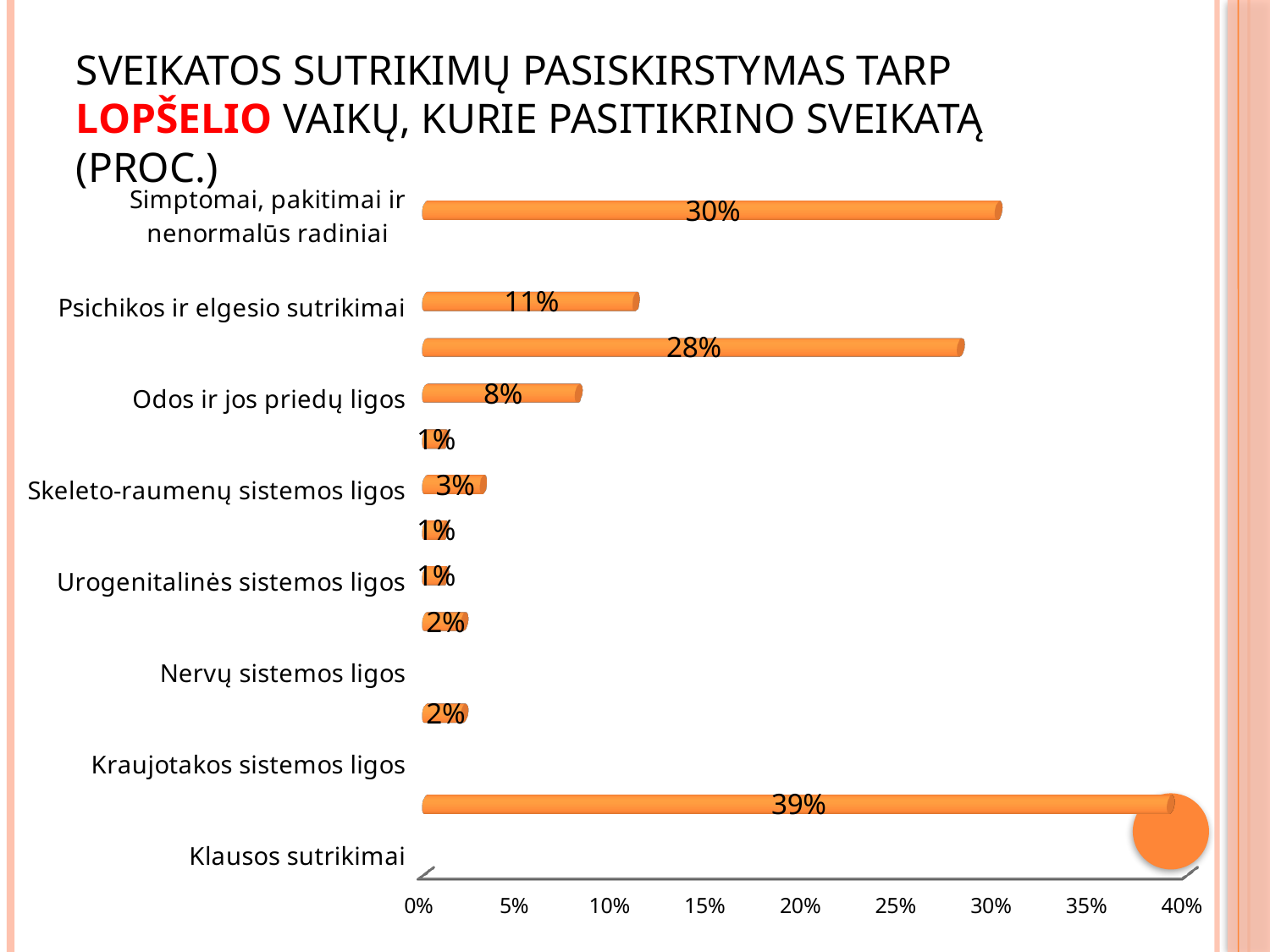
Which is larger, the value for Psichikos ir elgesio sutrikimai or the value for Odos ir jos priedų ligos? Psichikos ir elgesio sutrikimai What is the value for Psichikos ir elgesio sutrikimai? 11% What is the value for Odos ir jos priedų ligos? 8% What is the largest value labelled on any bar in the chart? 39% What is the value for Urogenitalinės sistemos ligos? 1% What kind of chart is shown on the slide? bar chart Is the value for Skeleto-raumenų sistemos ligos greater or less than 5%? less Is the value for Simptomai, pakitimai ir nenormalūs radiniai greater or less than 25%? greater What is the highest tick value shown on the horizontal axis? 40% What is the value for Skeleto-raumenų sistemos ligos? 3% What is the value for Simptomai, pakitimai ir nenormalūs radiniai? 30% What is the difference between the values for Simptomai, pakitimai ir nenormalūs radiniai and Psichikos ir elgesio sutrikimai? 19%